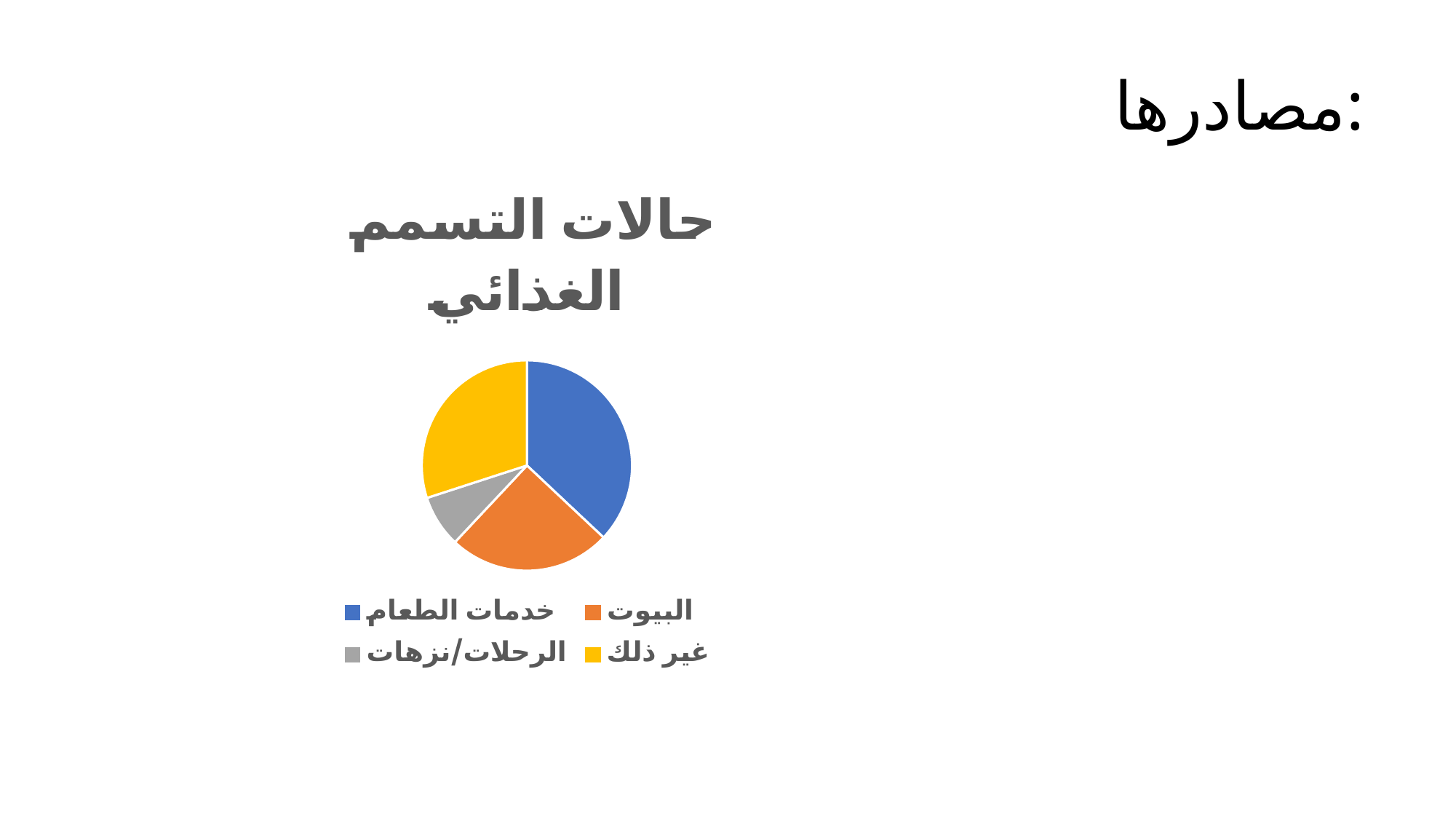
Which slice is larger, خدمات الطعام or غير ذلك? خدمات الطعام What is the title of the chart? حالات التسمم الغذائي What kind of chart is shown on the slide? pie chart How many entries does the legend list? 4 Which category has the smallest slice of the pie? الرحلات/نزهات Which slice is larger, خدمات الطعام or الرحلات/نزهات? خدمات الطعام How many categories does the pie chart have? 4 Which slice is larger, البيوت or الرحلات/نزهات? البيوت Which category has the largest slice of the pie? خدمات الطعام What colour is the slice for البيوت? orange